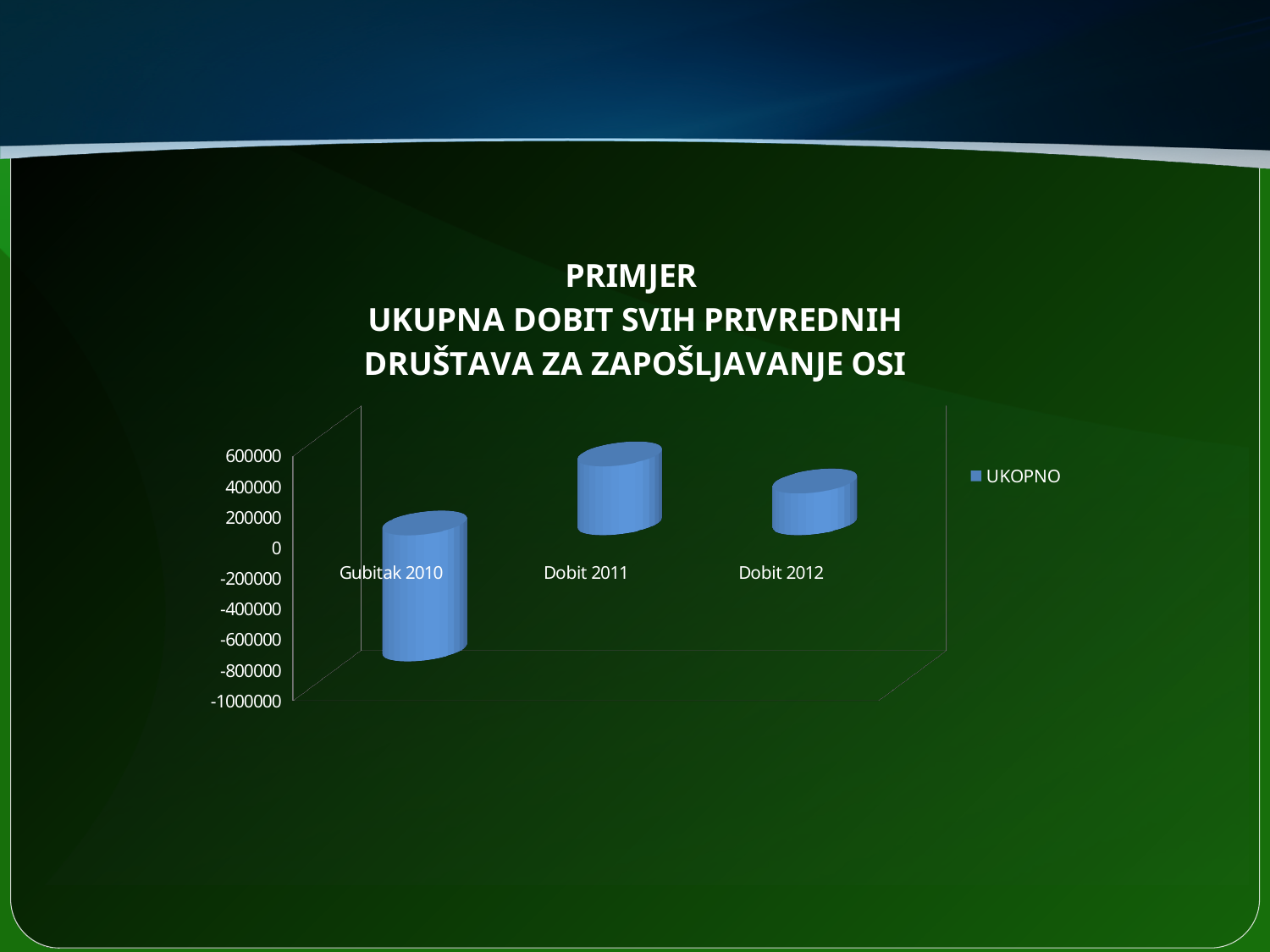
How many series does the chart's legend list? 1 Which category has the highest value in the chart? Dobit 2011 What kind of chart is shown on the slide? Bar chart Is the value for Dobit 2012 greater or less than 0? greater Is the value for Dobit 2011 greater or less than 200000? greater Which is larger, the value for Dobit 2011 or the value for Dobit 2012? Dobit 2011 Which category has the lowest value in the chart? Gubitak 2010 Is the value for Gubitak 2010 greater or less than 0? less Does the value rise or fall from Dobit 2011 to Dobit 2012? fall What is the name of the series shown in the chart's legend? UKOPNO How many categories are plotted on the x axis of the chart? 3